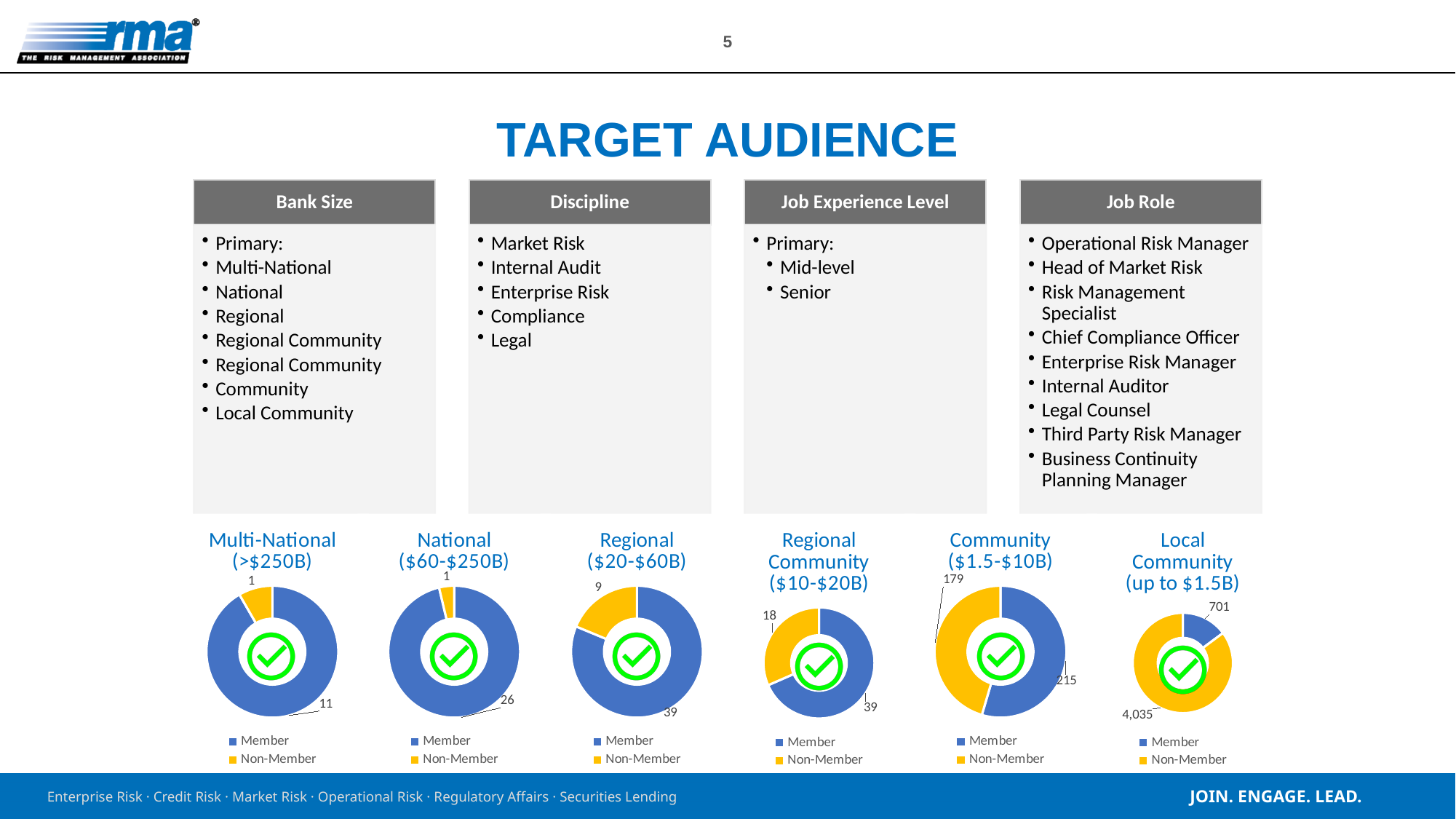
In the Community ($1.5-$10B) chart, what is the difference between Member and Non-Member? 36 In the Regional ($20-$60B) chart, what is the value for Non-Member? 9 How many series does the legend of the National ($60-$250B) chart list? 2 In the National ($60-$250B) chart, what is the value for Non-Member? 1 In the Regional Community ($10-$20B) chart, what is the total of Member and Non-Member? 57 How many donut charts are shown on the slide? 6 In the Local Community (up to $1.5B) chart, what is the value for Non-Member? 4,035 In the Regional Community ($10-$20B) chart, what is the value for Member? 39 In the Community ($1.5-$10B) chart, what is the value for Non-Member? 179 In the Local Community (up to $1.5B) chart, which segment is larger, Member or Non-Member? Non-Member What kind of chart is used for the Multi-National (>$250B) data? Donut chart In the Multi-National (>$250B) chart, what is the value for Member? 11